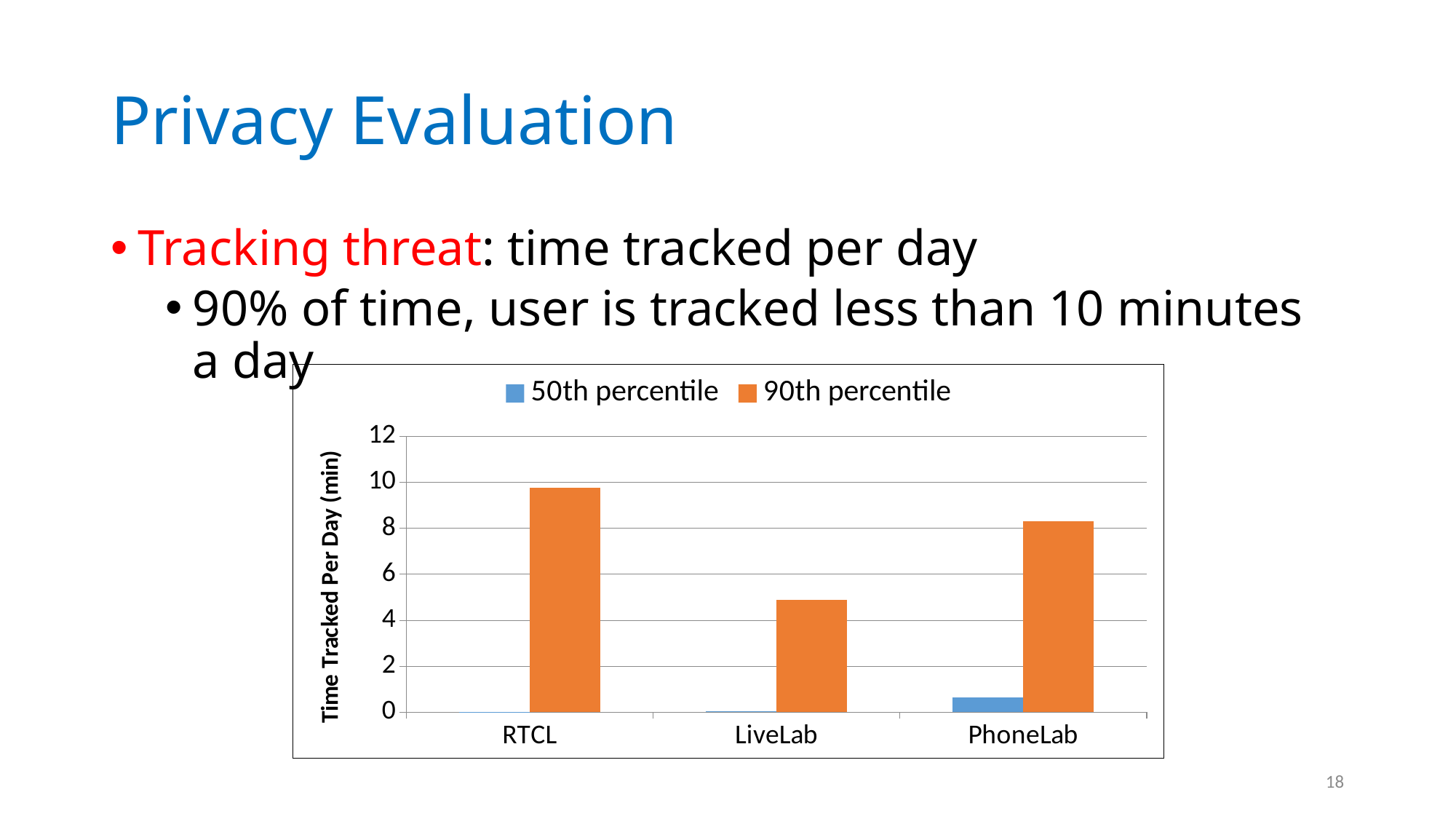
Is the 90th percentile value for PhoneLab greater or less than 10? less Which category has the highest 90th percentile value? RTCL What kind of chart is shown on the slide? bar chart Which category has the lowest 90th percentile value? LiveLab Is the 90th percentile value for LiveLab greater or less than 6? less How many categories are shown on the x axis of the chart? 3 Which is larger, the 90th percentile value for LiveLab or for PhoneLab? PhoneLab Which colour represents the 90th percentile series in the chart? orange Which category has the highest 50th percentile value? PhoneLab What is the label of the y axis of the chart? Time Tracked Per Day (min) Is the 90th percentile value for RTCL greater or less than 8? greater How many series does the chart legend list? 2